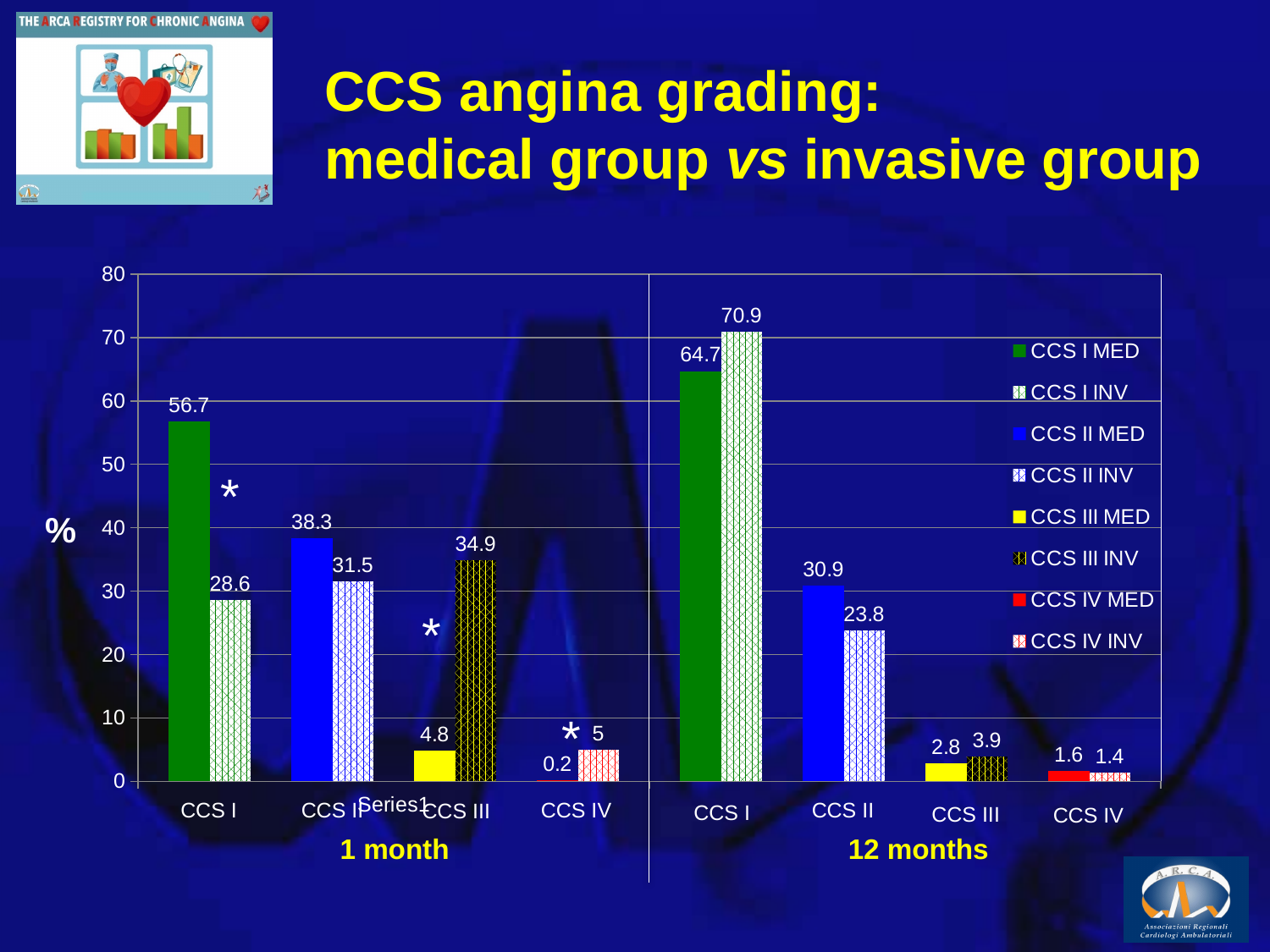
What is the value for CCS III INV at 1 month? 34.9 Which bar has the lowest value on the chart? CCS IV MED at 1 month What is the difference between CCS I MED and CCS I INV at 1 month? 28.1 What is the value for CCS I INV at 12 months? 70.9 At 1 month, which is larger: CCS III MED or CCS III INV? CCS III INV What colour are the CCS I MED bars? Green What kind of chart is shown on the slide? Bar chart What is the difference between CCS II MED and CCS II INV at 12 months? 7.1 What is the value for CCS I MED at 1 month? 56.7 Which bar has the highest value on the chart? CCS I INV at 12 months What is the value for CCS IV MED at 1 month? 0.2 How many series does the legend list? 8